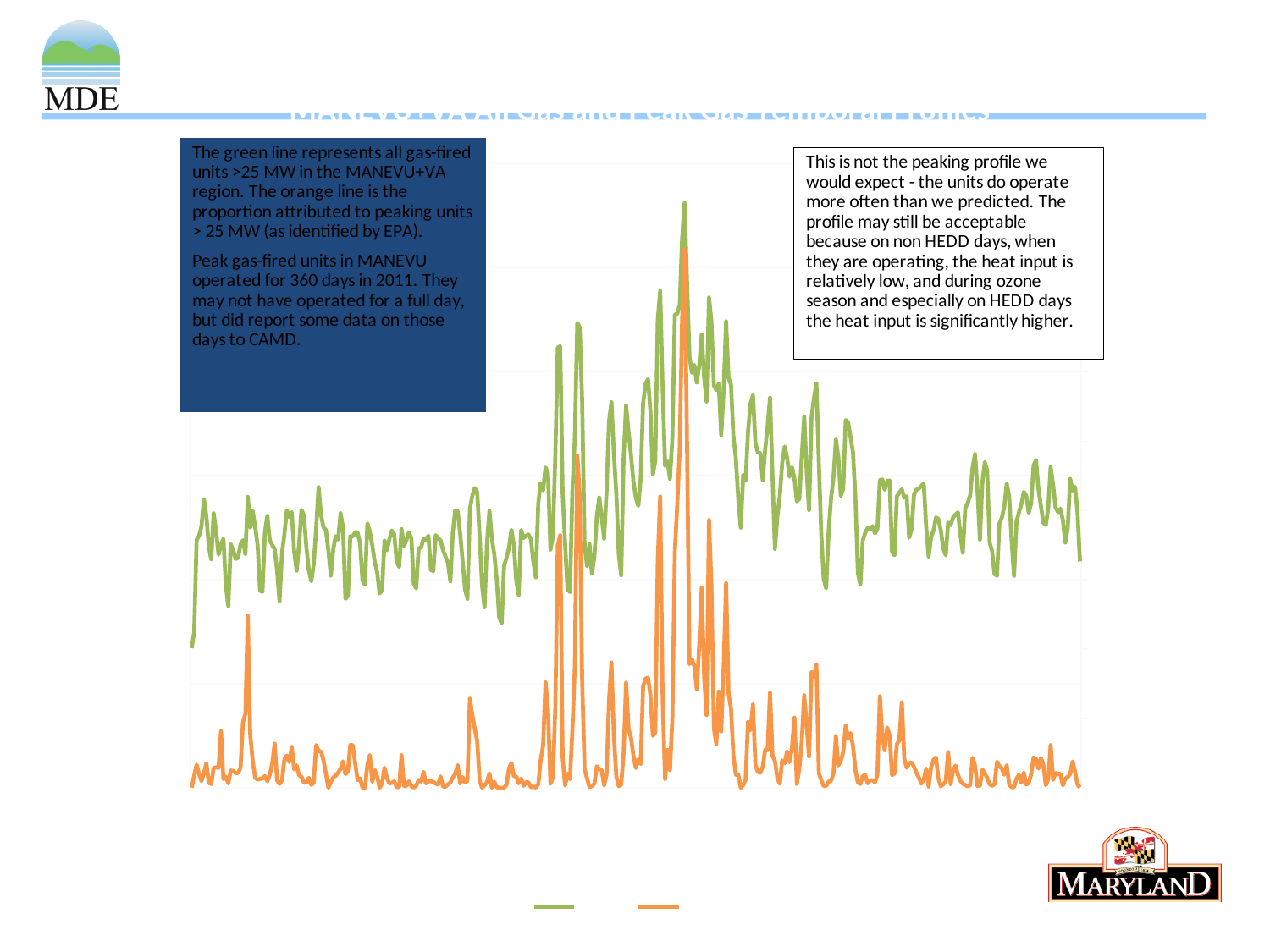
According to the text box on the slide, which line represents the proportion attributed to peaking units > 25 MW? the orange line Which line reaches the highest point on the chart, the green line or the orange line? green What colours are the two lines plotted on the chart? green and orange What kind of chart is shown on the slide? line chart How many series does the legend at the bottom of the chart show? 2 In which part of the x axis do both the green and orange lines reach their highest peaks: the left, the middle, or the right? the middle Which line lies higher on the chart across most of the x axis, the green line or the orange line? green